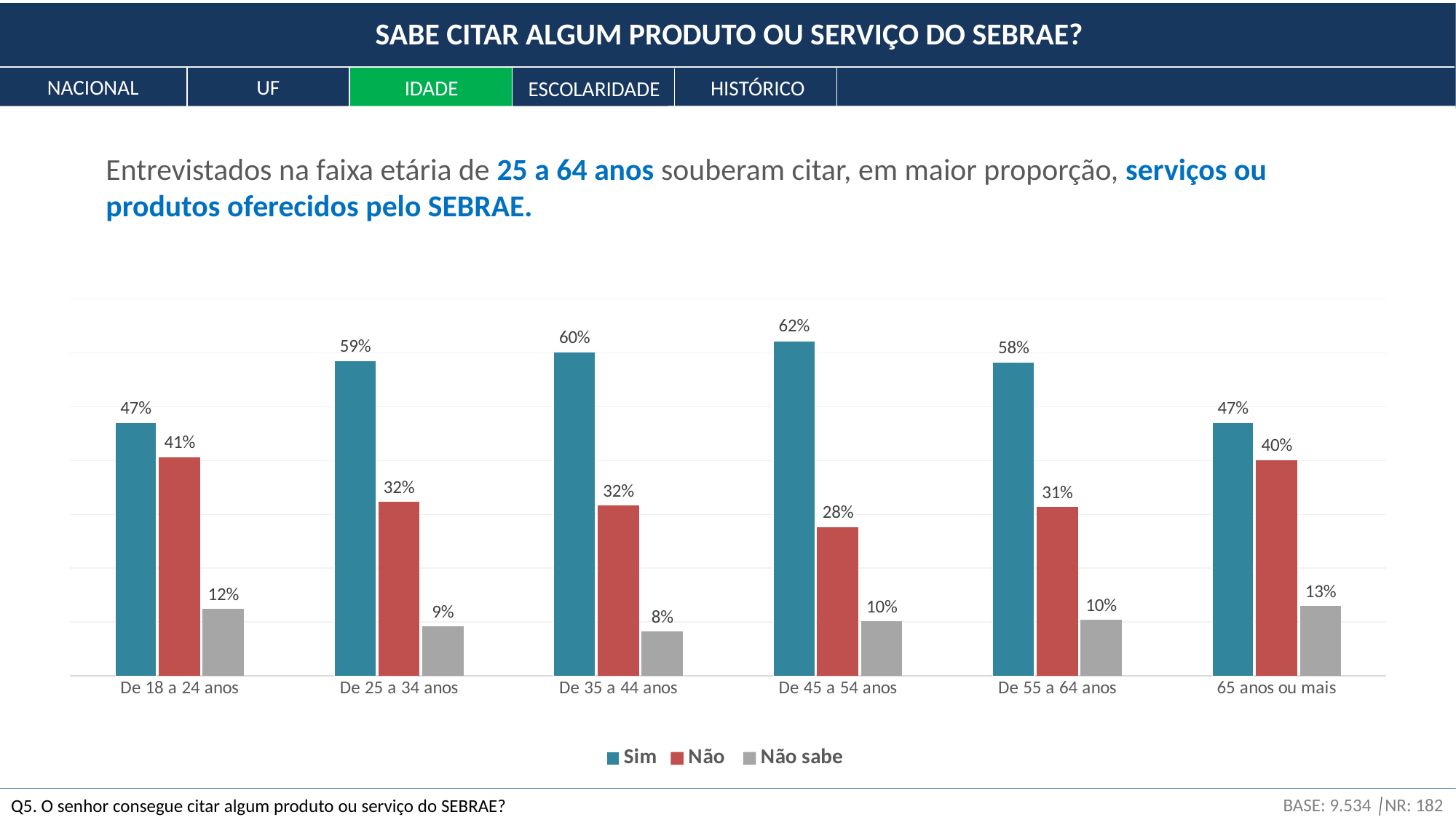
What kind of chart is shown on the slide? Bar chart How many series does the legend list? 3 Which age group has the lowest 'Não sabe' value? De 35 a 44 anos What is the value of 'Não' for the 'De 18 a 24 anos' age group? 41% What is the 'Não' value for the 'De 55 a 64 anos' age group? 31% How many age groups are shown on the x axis? 6 Which age group has the highest 'Sim' value? De 45 a 54 anos What is the value of 'Não sabe' for the '65 anos ou mais' age group? 13% Which is larger: the 'Não' value for 'De 18 a 24 anos' or the 'Não' value for '65 anos ou mais'? De 18 a 24 anos What is the value of 'Sim' for the 'De 45 a 54 anos' age group? 62% Which series is shown in red in the legend? Não What is the difference between the 'Sim' and 'Não' values for the 'De 25 a 34 anos' age group? 27%